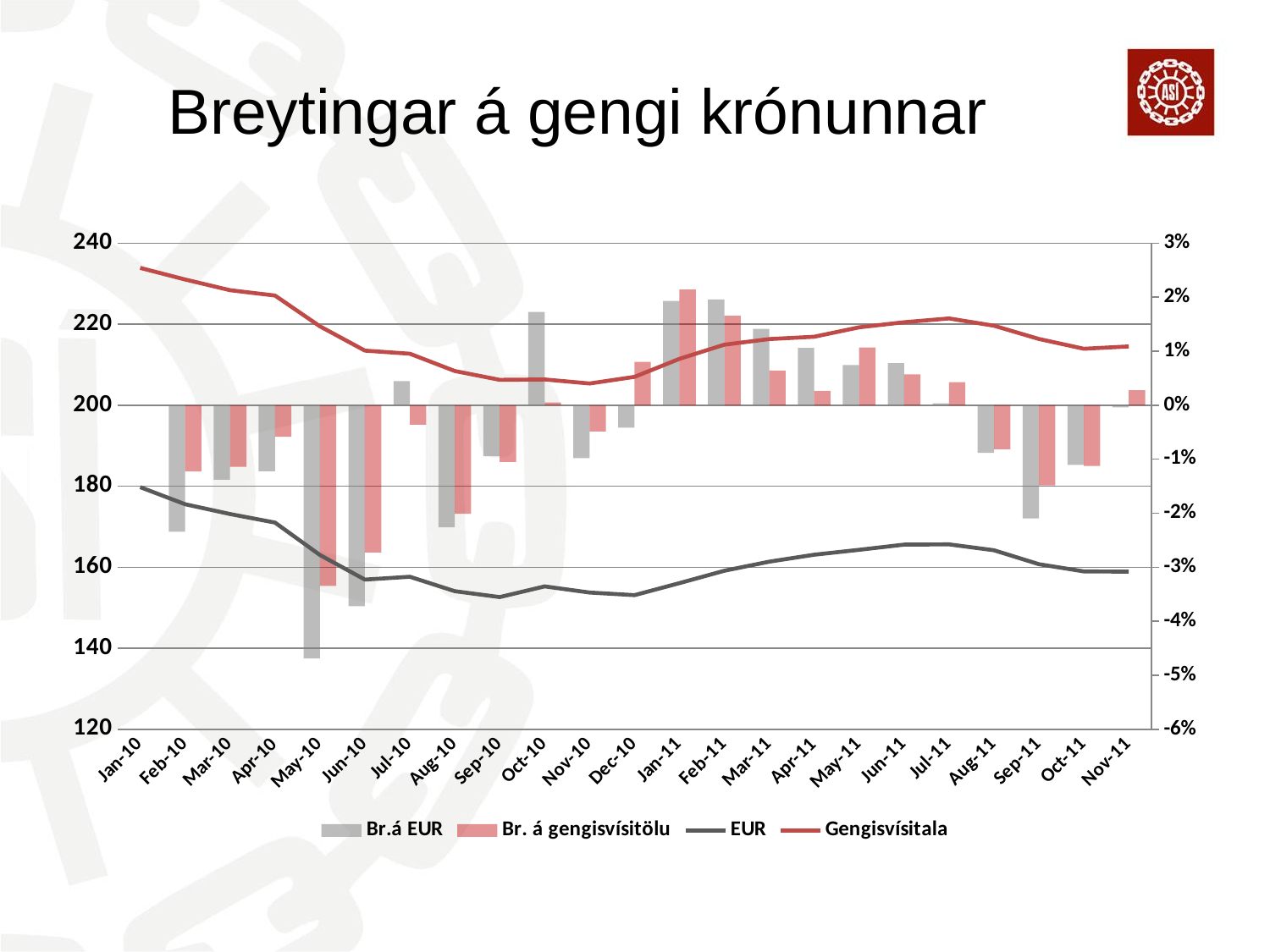
Does the Gengisvísitala line rise or fall from Jan-10 to Oct-10? fall How many months are shown along the x axis? 23 What kind of chart is shown on the slide? A combined bar and line chart At May-10, which bar is lower, Br.á EUR or Br. á gengisvísitölu? Br.á EUR Is the Gengisvísitala value at Jan-10 greater or less than 220? greater Which line is higher at Jan-11, EUR or Gengisvísitala? Gengisvísitala In which month is the Br. á gengisvísitölu bar highest? Jan-11 Is the Br.á EUR value at May-10 greater or less than -4%? less Is the EUR value at Sep-10 greater or less than 160? less What is the title of the slide? Breytingar á gengi krónunnar In which month is the Br.á EUR bar lowest? May-10 How many series does the legend list? 4